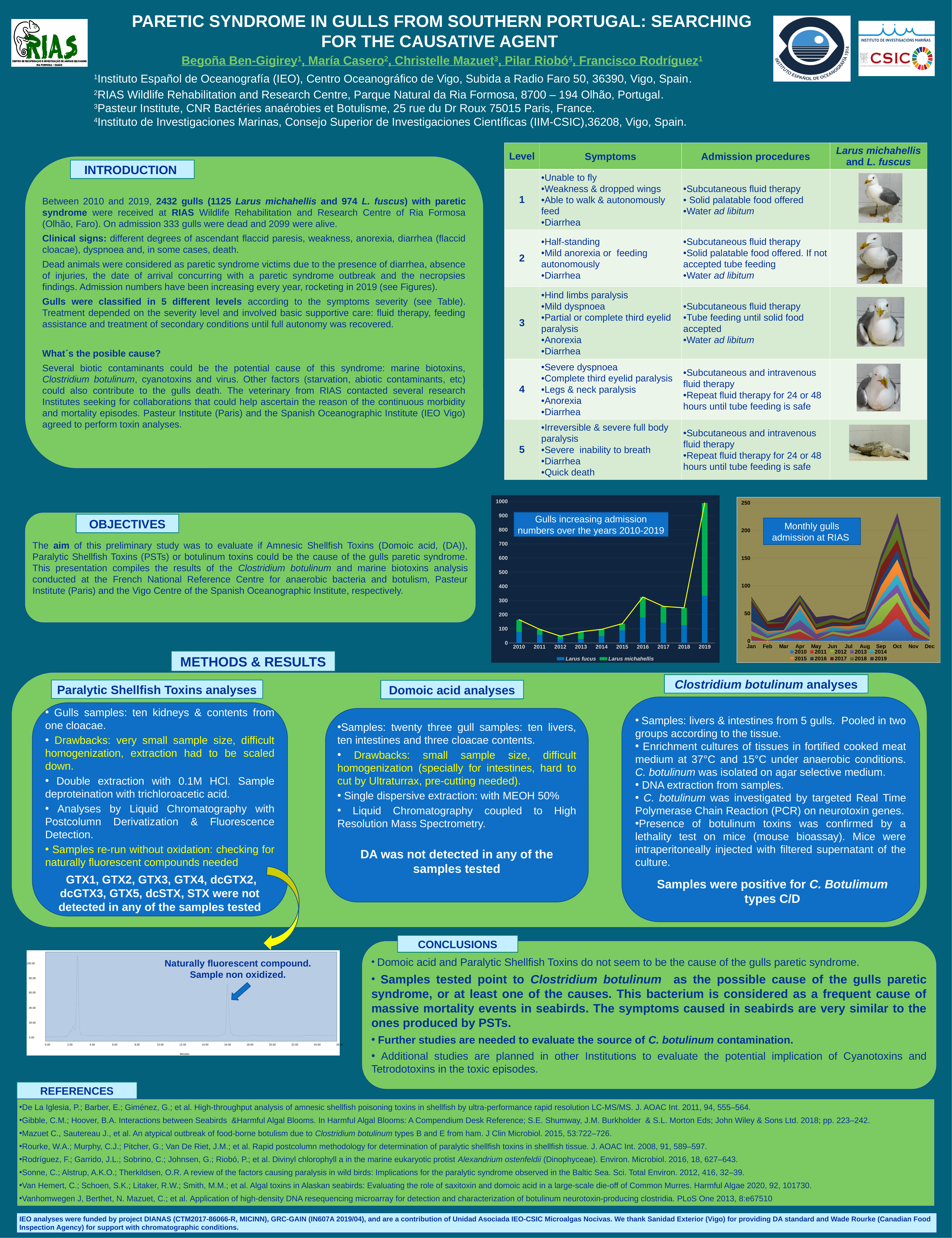
In the 'Gulls increasing admission numbers over the years 2010-2019' chart, is the total for 2019 greater or less than 800? greater In the 'Gulls increasing admission numbers over the years 2010-2019' chart, is the total for 2016 greater or less than 400? less How many series does the legend of the 'Monthly gulls admission at RIAS' chart list? 10 What kind of chart is the 'Gulls increasing admission numbers over the years 2010-2019' chart? combination bar and line chart In the 'Monthly gulls admission at RIAS' chart, which month has the highest stacked total? Oct How many years are shown on the x axis of the 'Gulls increasing admission numbers over the years 2010-2019' chart? 10 In the 'Gulls increasing admission numbers over the years 2010-2019' chart, which year has the highest total admissions? 2019 In the 'Gulls increasing admission numbers over the years 2010-2019' chart, does the total rise or fall from 2018 to 2019? rise In the 'Gulls increasing admission numbers over the years 2010-2019' chart, which year has the larger total, 2016 or 2017? 2016 How many series does the legend of the 'Gulls increasing admission numbers over the years 2010-2019' chart list? 2 In the 'Gulls increasing admission numbers over the years 2010-2019' chart, which year has the lowest total admissions? 2012 What are the two legend entries of the 'Gulls increasing admission numbers over the years 2010-2019' chart? Larus fucus and Larus michahellis